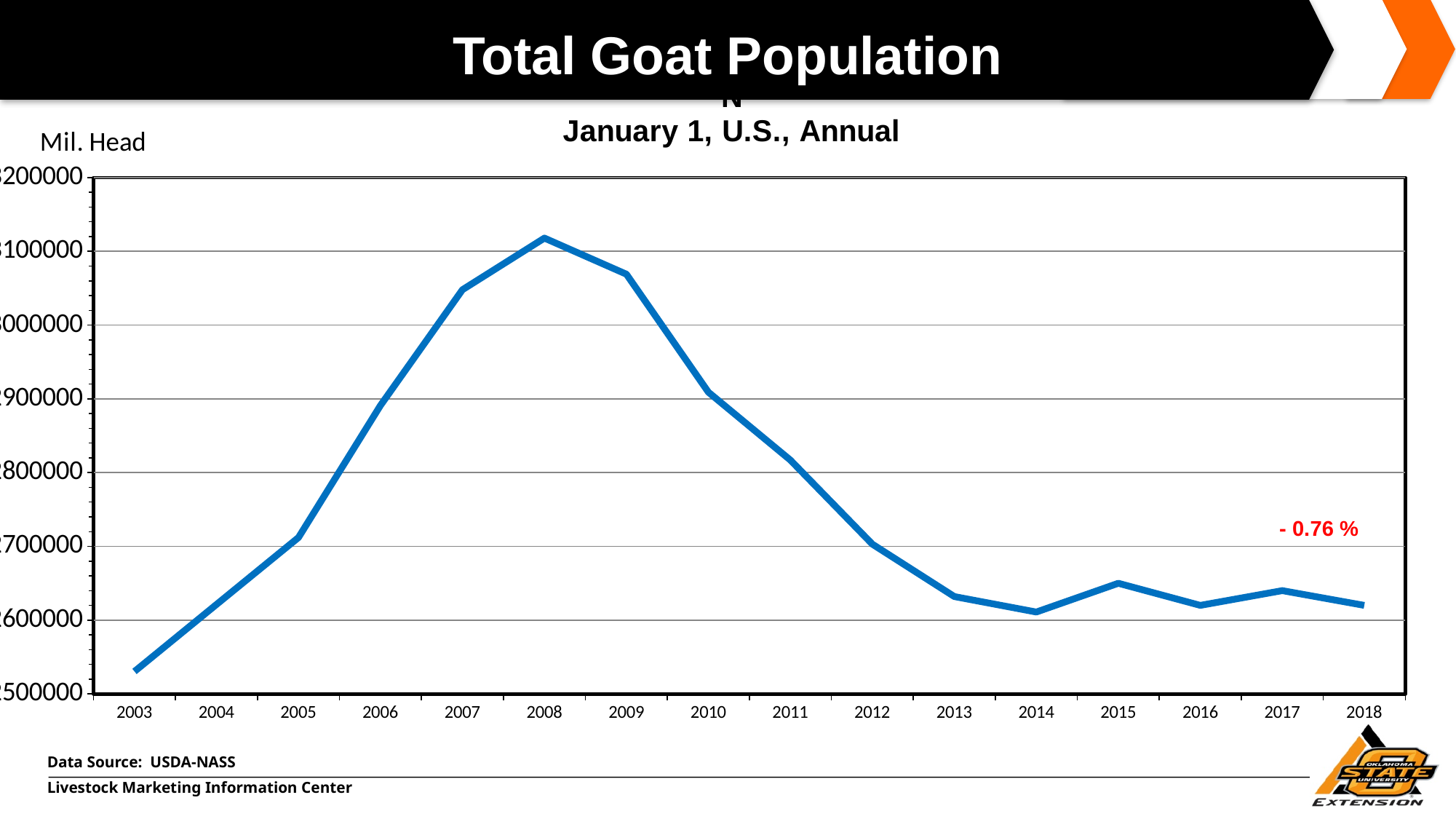
Is the value for 2011 greater or less than 2900000? less Is the value for 2003 greater or less than 2600000? less Which year has the larger goat population, 2005 or 2010? 2010 In which year is the total goat population lowest? 2003 In which year is the total goat population highest? 2008 Is the value for 2008 greater or less than 3000000? greater Does the goat population rise or fall from 2003 to 2008? rise How many years are plotted along the x axis? 16 Does the goat population rise or fall from 2008 to 2014? fall What kind of chart is shown on the slide? line chart What percentage change is annotated in red near the end of the line? - 0.76 % Which year has the larger goat population, 2003 or 2018? 2018